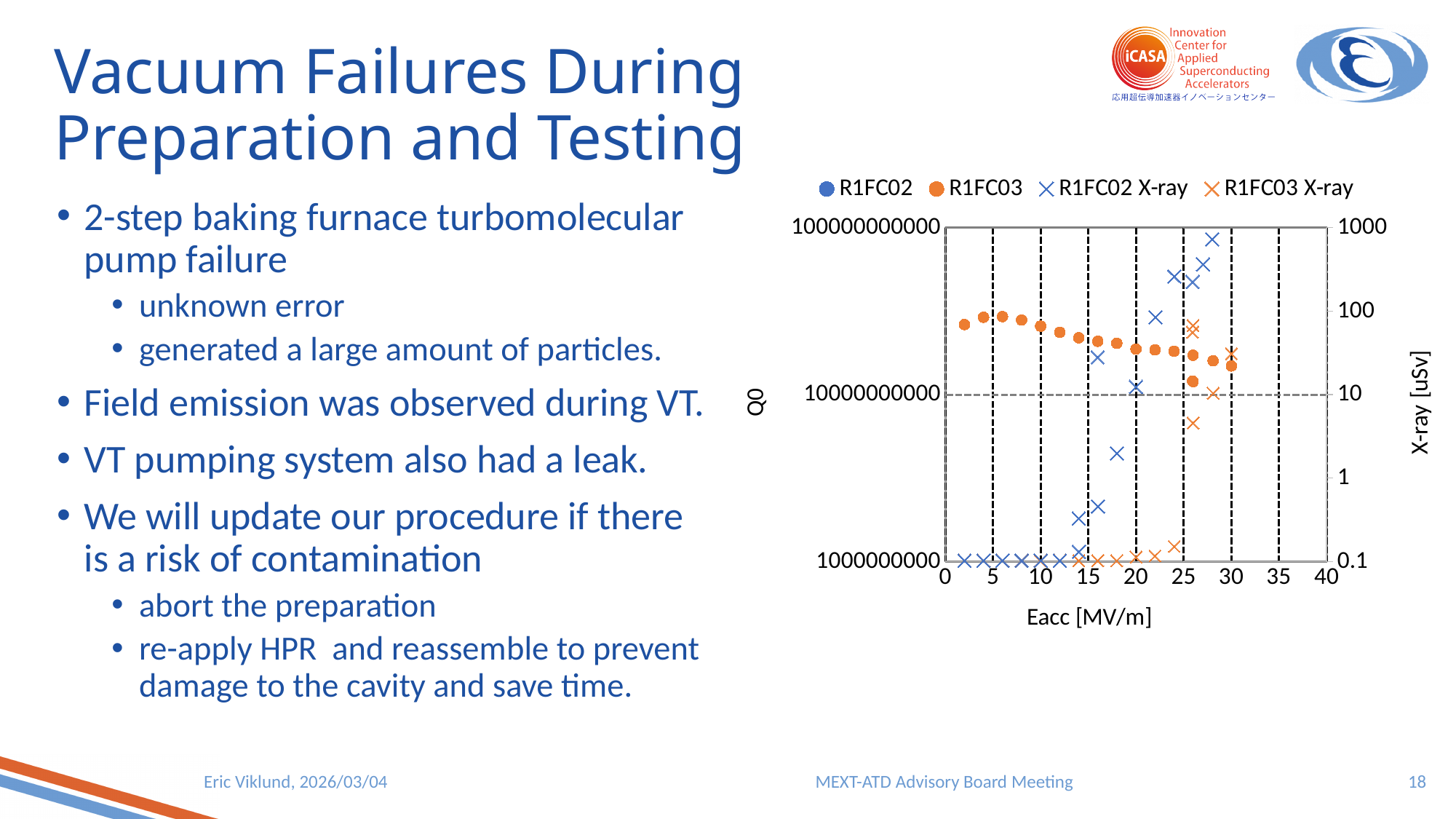
What is the title of the horizontal axis of the chart? Eacc [MV/m] Is the R1FC02 X-ray value at 18 MV/m greater or less than 10 uSv? less Is the R1FC02 X-ray value at 28 MV/m greater or less than 100 uSv? greater Do the R1FC02 X-ray values rise or fall as Eacc increases from 15 to 28 MV/m? rise At 28 MV/m, which series has the higher X-ray value, R1FC02 X-ray or R1FC03 X-ray? R1FC02 X-ray How many series does the chart legend list? 4 Is the R1FC03 Q0 value at 5 MV/m greater or less than 10000000000? greater What is the title of the right-hand vertical axis of the chart? X-ray [uSv] What kind of chart is shown on the slide? scatter chart Do the R1FC03 Q0 values rise or fall as Eacc increases from 5 to 30 MV/m? fall